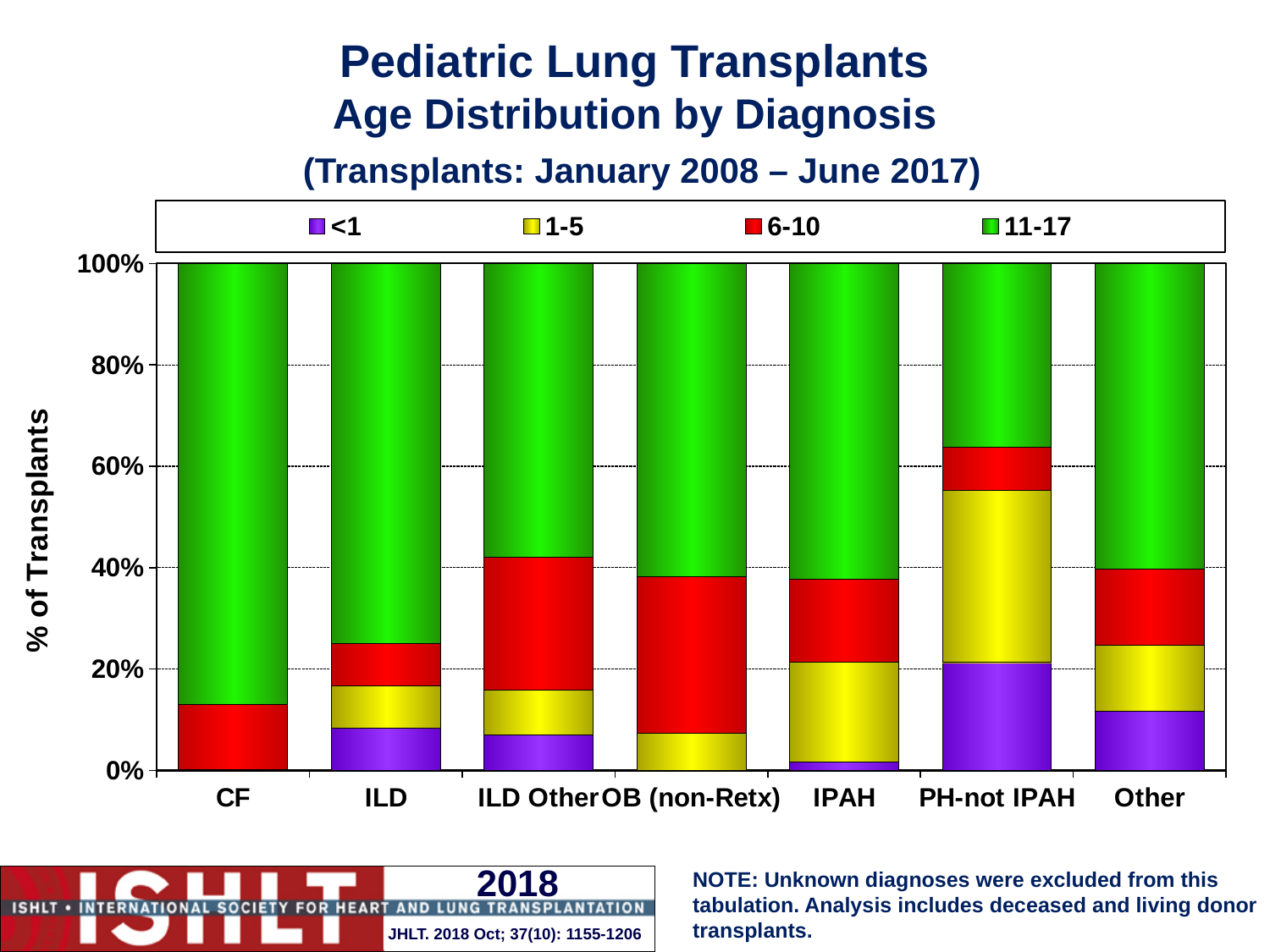
What is the total of the stacked bar for IPAH? 100% Is the 6-10 segment larger for OB (non-Retx) or for ILD? OB (non-Retx) Which diagnosis has the smallest share of transplants in the 11-17 age group? PH-not IPAH Is the 11-17 share for ILD Other greater or less than 50%? greater Is the 11-17 share for PH-not IPAH greater or less than 40%? less How many age-group series does the legend list? 4 Which diagnosis has the largest share of transplants in the 11-17 age group? CF What are the four age groups listed in the legend? <1, 1-5, 6-10, 11-17 Which diagnosis has the largest share of transplants in the <1 age group? PH-not IPAH What kind of chart is shown on the slide? Stacked bar chart Is the 11-17 share for CF greater or less than 80%? greater How many diagnosis categories are shown on the x axis? 7